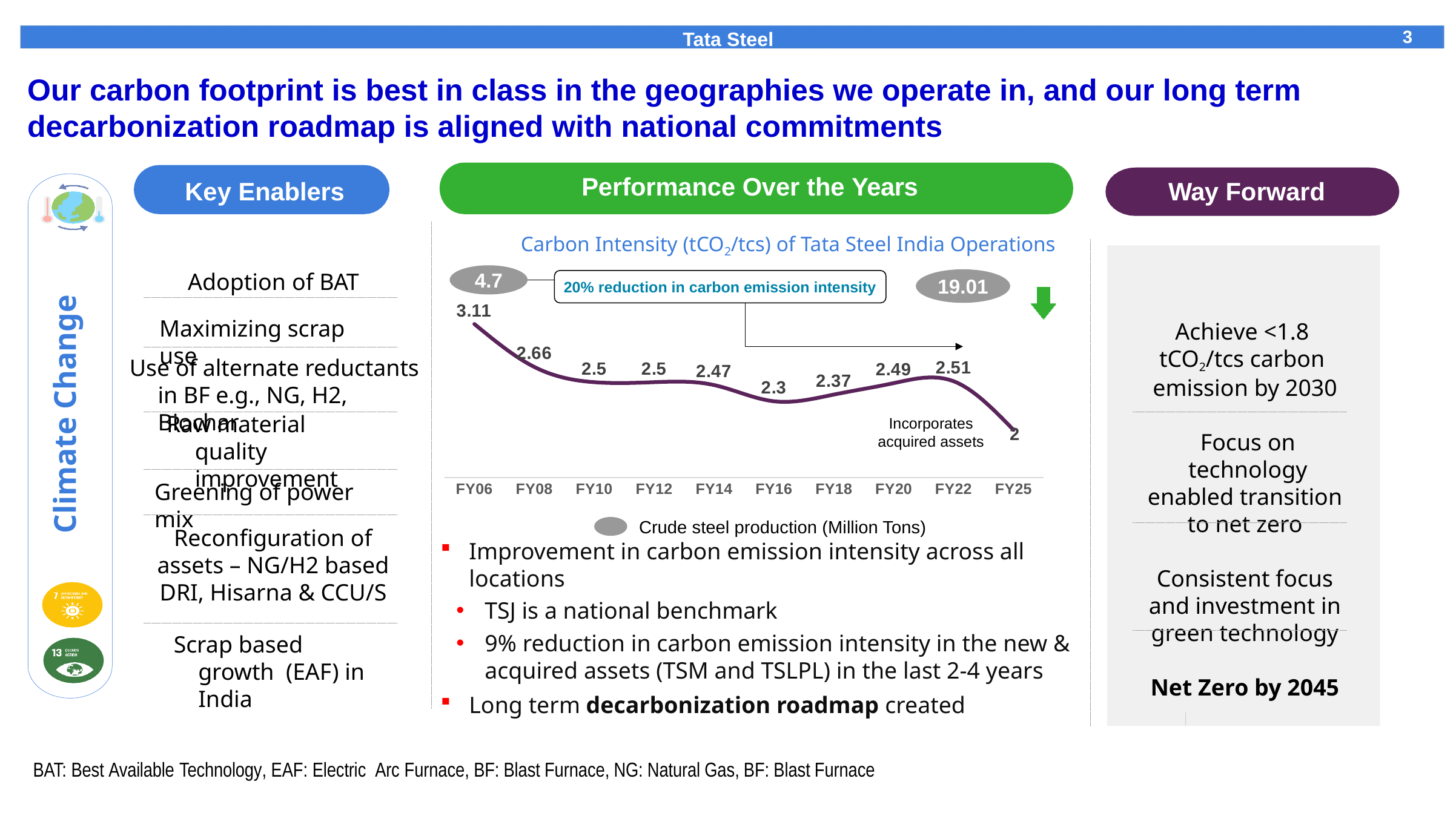
What is the carbon intensity value shown for FY25? 2 Which is larger, the carbon intensity value for FY08 or for FY20? FY08 Which fiscal year has the lowest carbon intensity value on the chart? FY25 What is the difference between the carbon intensity values for FY06 and FY25? 1.11 Which fiscal year has the highest carbon intensity value on the chart? FY06 What is the carbon intensity value shown for FY06? 3.11 What is the carbon intensity value shown for FY22? 2.51 How many fiscal years are plotted on the carbon intensity chart? 10 What is the carbon intensity value shown for FY16? 2.3 What is the title of the chart in the Performance Over the Years section? Carbon Intensity (tCO2/tcs) of Tata Steel India Operations What kind of chart is used to show carbon intensity over the years? Line chart Does the carbon intensity generally rise or fall from FY06 to FY25? Fall